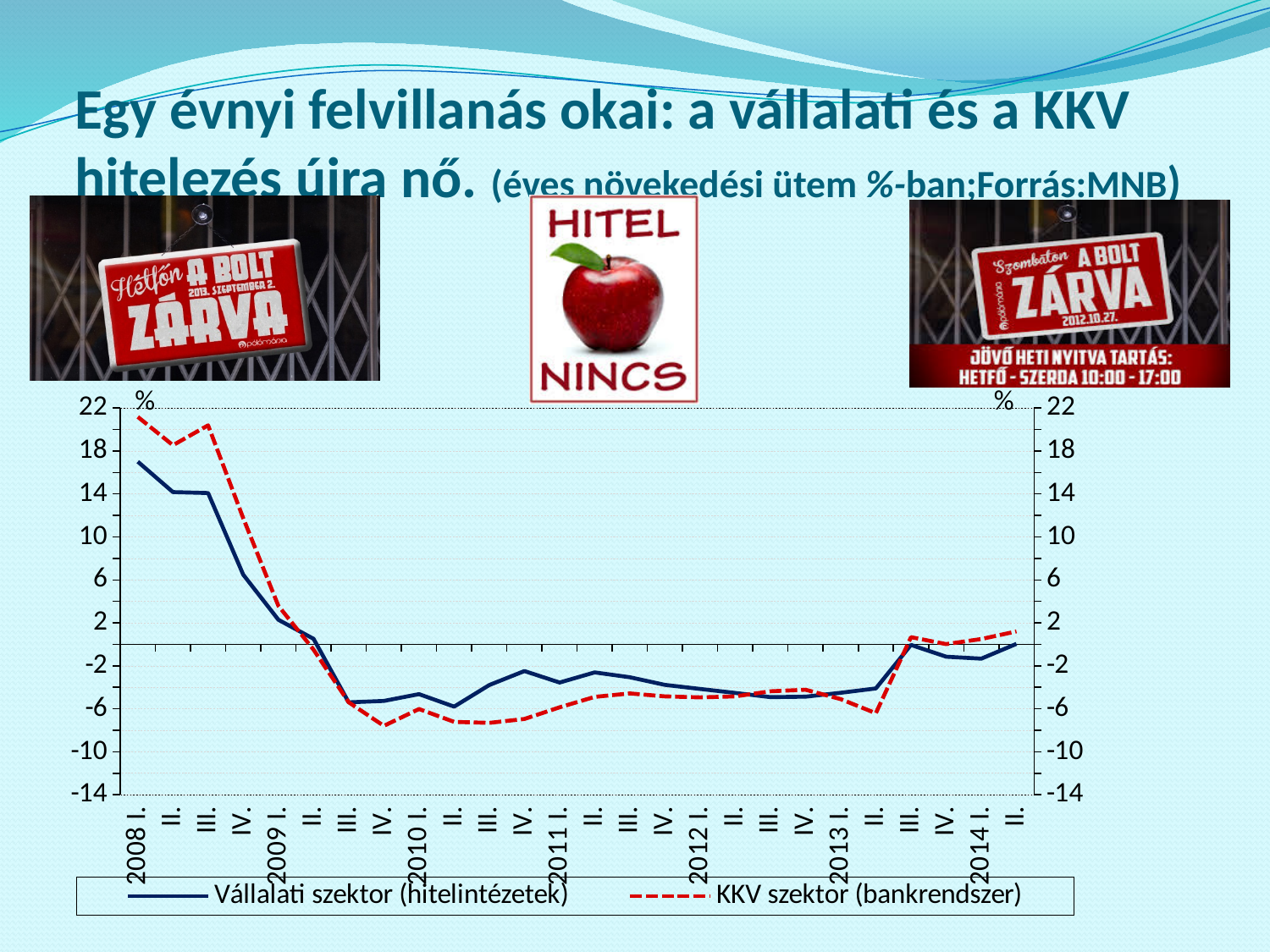
In 2013 II., which series has the lower value, Vállalati szektor (hitelintézetek) or KKV szektor (bankrendszer)? KKV szektor (bankrendszer) What is the first quarter label shown on the x axis? 2008 I. How many series does the legend list? 2 Which series is drawn as a red dashed line? KKV szektor (bankrendszer) Do the values of the Vállalati szektor (hitelintézetek) series rise or fall from 2008 I. to 2009 IV.? fall How many quarterly points are plotted along the x axis for each series? 26 Is the value for Vállalati szektor (hitelintézetek) in 2009 IV. greater or less than -2? less In which quarter does the KKV szektor (bankrendszer) series reach its highest value? 2008 I. Is the value for Vállalati szektor (hitelintézetek) in 2008 III. greater or less than 10? greater What kind of chart is shown on the slide? line chart Is the value for KKV szektor (bankrendszer) in 2008 I. greater or less than 18? greater In 2008 I., which series has the higher value, Vállalati szektor (hitelintézetek) or KKV szektor (bankrendszer)? KKV szektor (bankrendszer)